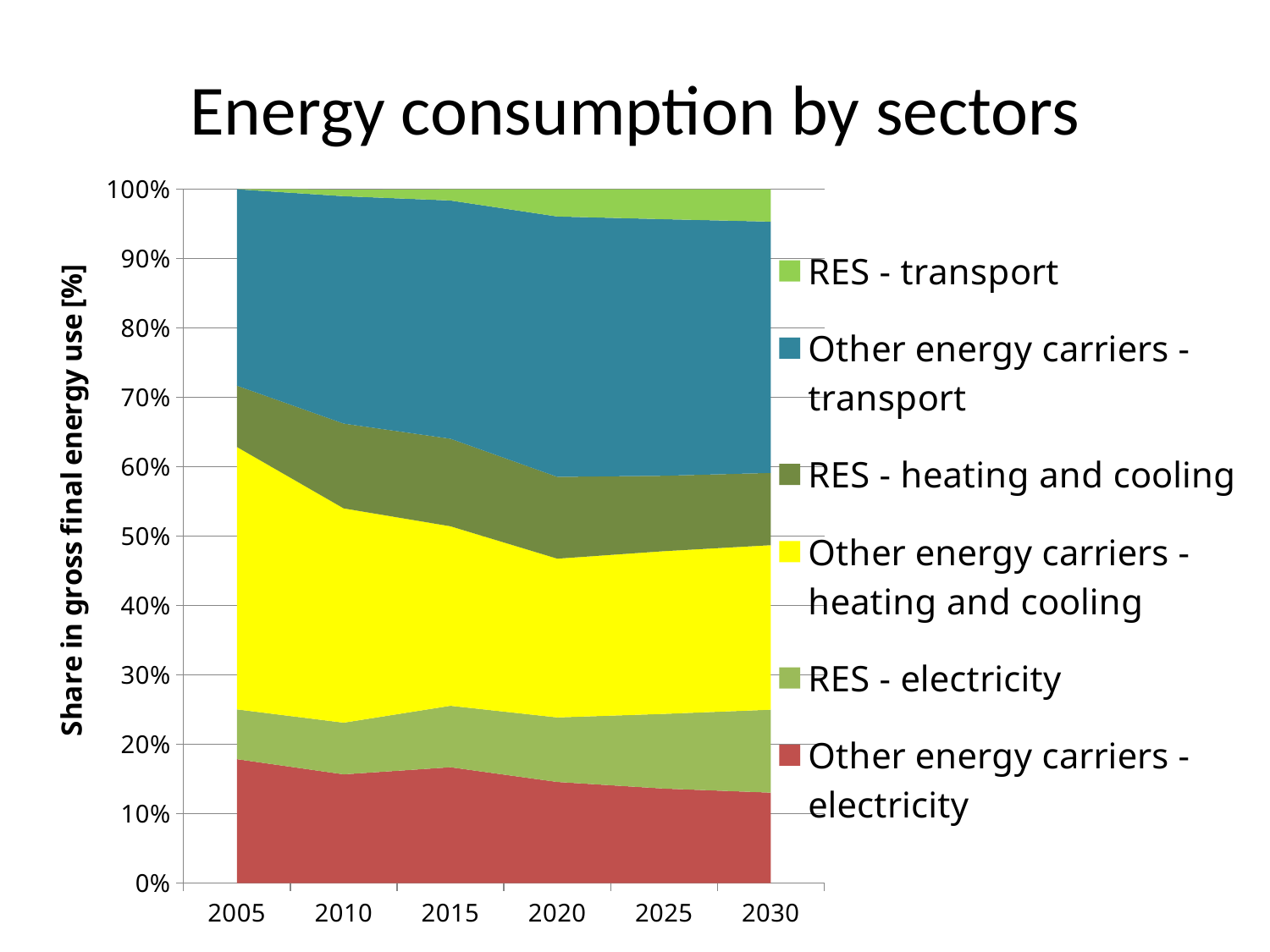
What kind of chart is shown on the slide? Stacked area chart Does the share of Other energy carriers - electricity rise or fall from 2005 to 2030? Fall What is the label of the vertical axis? Share in gross final energy use [%] Is the share of Other energy carriers - heating and cooling in 2030 greater or less than 30%? less How many series does the legend list? 6 Which series has the largest share in 2030? Other energy carriers - transport Is the share of RES - transport in 2005 greater or less than 10%? less How many years are shown along the x axis? 6 Does the share of RES - transport rise or fall from 2005 to 2030? Rise Is the share of Other energy carriers - electricity in 2005 greater or less than 10%? greater Which series has the smallest share in 2005? RES - transport What is the title of the chart? Energy consumption by sectors